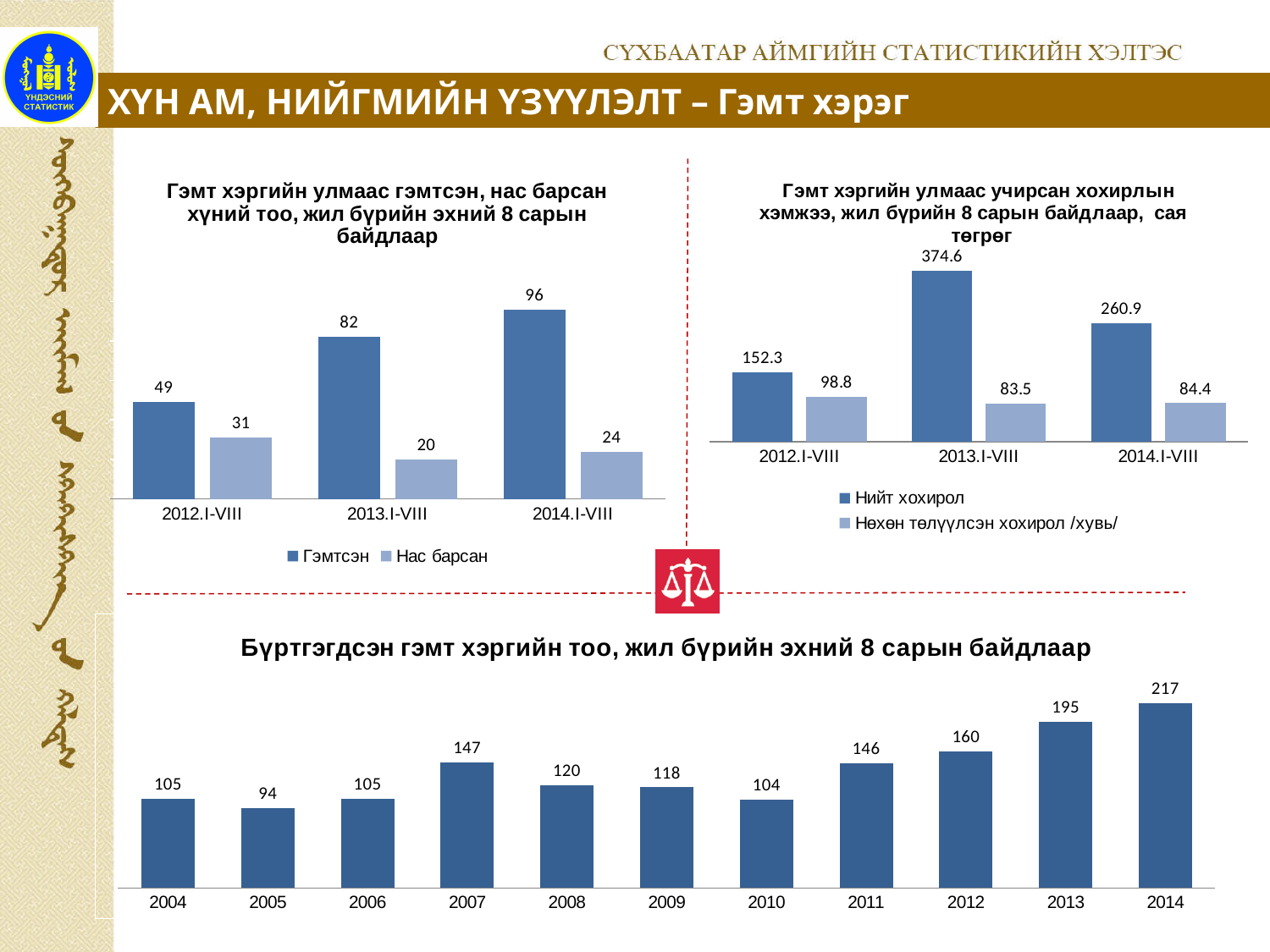
In the top-left chart (Гэмт хэргийн улмаас гэмтсэн, нас барсан хүний тоо), what is the difference between Гэмтсэн and Нас барсан in 2014.I-VIII? 72 In the bottom chart (Бүртгэгдсэн гэмт хэргийн тоо), which year has the highest value? 2014 In the top-left chart (Гэмт хэргийн улмаас гэмтсэн, нас барсан хүний тоо), how many series does the legend list? 2 In the top-left chart (Гэмт хэргийн улмаас гэмтсэн, нас барсан хүний тоо), what is the value for Гэмтсэн in 2013.I-VIII? 82 In the bottom chart (Бүртгэгдсэн гэмт хэргийн тоо), what is the difference between the values for 2014 and 2013? 22 In the top-left chart (Гэмт хэргийн улмаас гэмтсэн, нас барсан хүний тоо), what is the value for Нас барсан in 2012.I-VIII? 31 In the bottom chart (Бүртгэгдсэн гэмт хэргийн тоо), what is the value for 2007? 147 In the bottom chart (Бүртгэгдсэн гэмт хэргийн тоо), which year has the lowest value? 2005 In the top-right chart (Гэмт хэргийн улмаас учирсан хохирлын хэмжээ), what is the value for Нийт хохирол in 2013.I-VIII? 374.6 In the top-right chart (Гэмт хэргийн улмаас учирсан хохирлын хэмжээ), which period has the lowest value for Нийт хохирол? 2012.I-VIII In the bottom chart (Бүртгэгдсэн гэмт хэргийн тоо), how many years are shown on the x axis? 11 In the top-right chart (Гэмт хэргийн улмаас учирсан хохирлын хэмжээ), what is the value for Нөхөн төлүүлсэн хохирол /хувь/ in 2014.I-VIII? 84.4